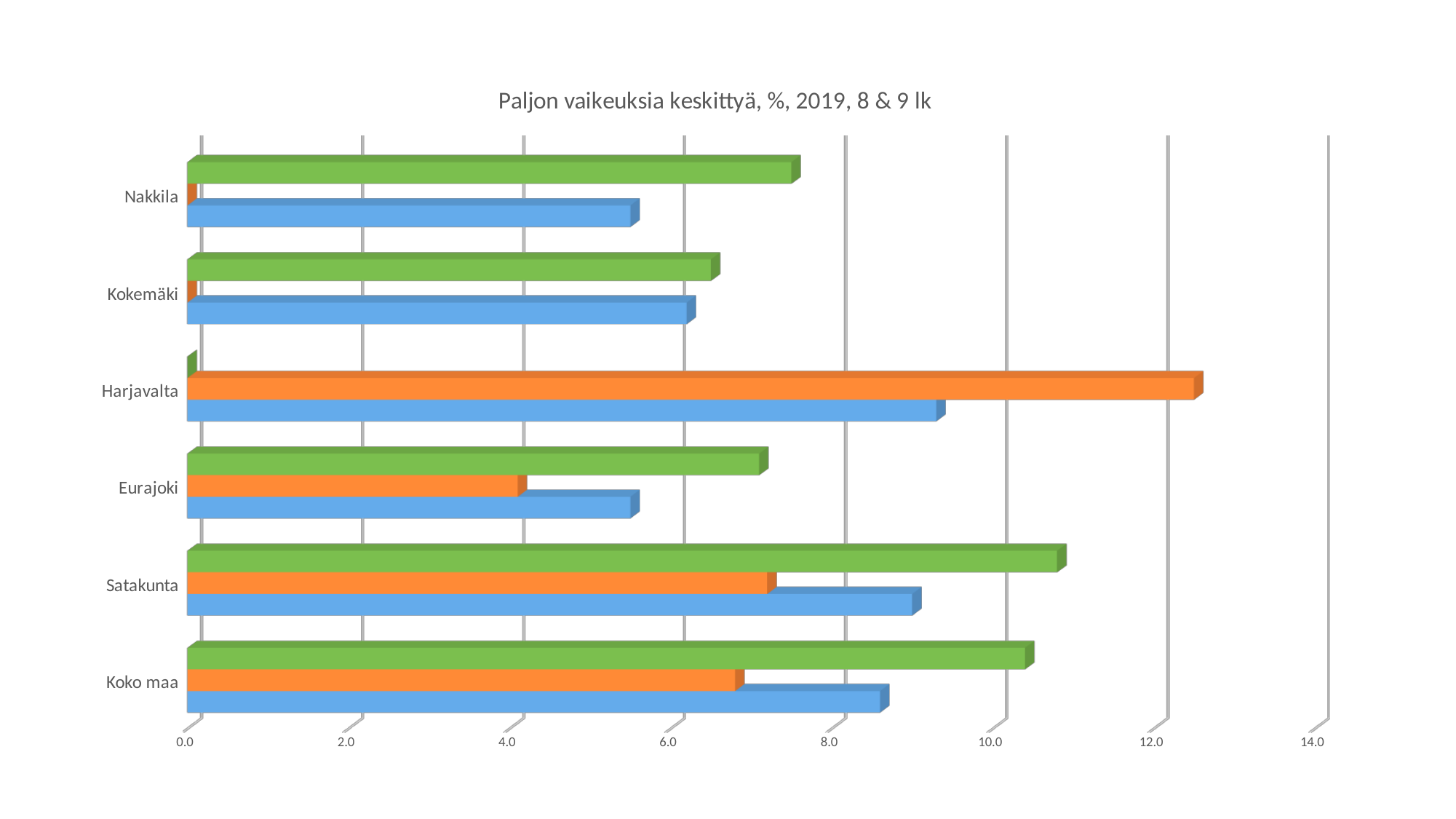
What is the title of the chart? Paljon vaikeuksia keskittyä, %, 2019, 8 & 9 lk Which category has the longest bar in the whole chart? Harjavalta Is the green bar for Satakunta greater or less than 10.0? greater Which is larger, the green bar for Nakkila or the green bar for Kokemäki? Nakkila Which category has the longest blue bar? Harjavalta Is the orange bar for Harjavalta greater or less than 12.0? greater How many bars are plotted for each category in the chart? 3 Is the blue bar for Nakkila greater or less than 6.0? less How many categories are shown on the vertical axis of the chart? 6 What kind of chart is shown on the slide? bar chart Which category has the shortest green bar? Harjavalta